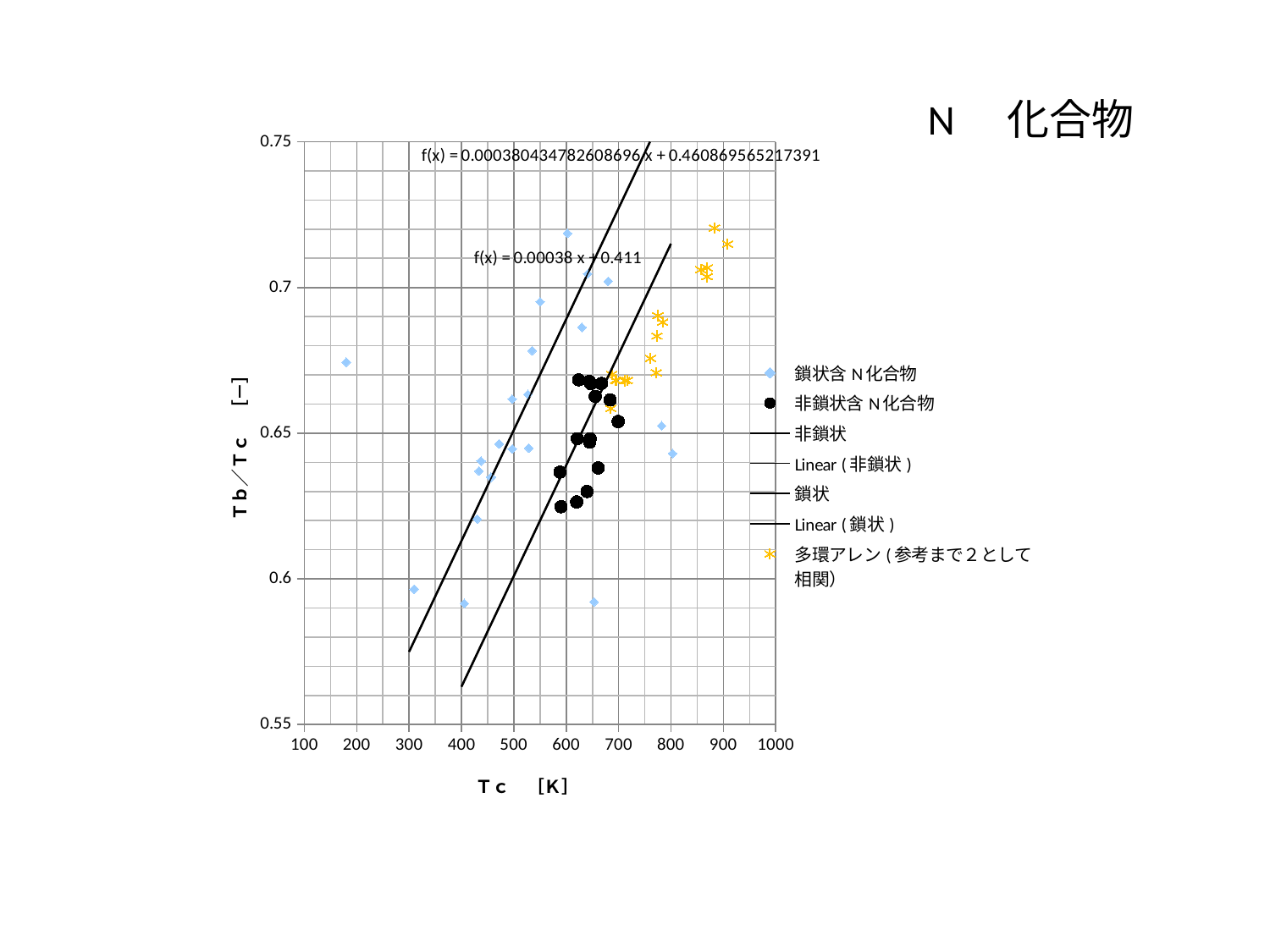
Is the Tb/Tc value of the lowest 非鎖状含N化合物 point greater or less than 0.65? less What is the title of the chart? N 化合物 What is the label of the x axis? Tc [K] What kind of chart is shown on the slide? scatter chart How many entries does the chart legend list? 7 What is the maximum value shown on the y axis? 0.75 Do the two fitted lines rise or fall as Tc increases? rise Is the Tb/Tc value of the leftmost 鎖状含N化合物 point (near Tc = 200) greater or less than 0.65? greater What is the minimum value shown on the x axis? 100 What is the intercept in the trendline equation f(x) = 0.000380434782608696x + ...? 0.460869565217391 Is the Tb/Tc value of the highest 多環アレン point greater or less than 0.7? greater